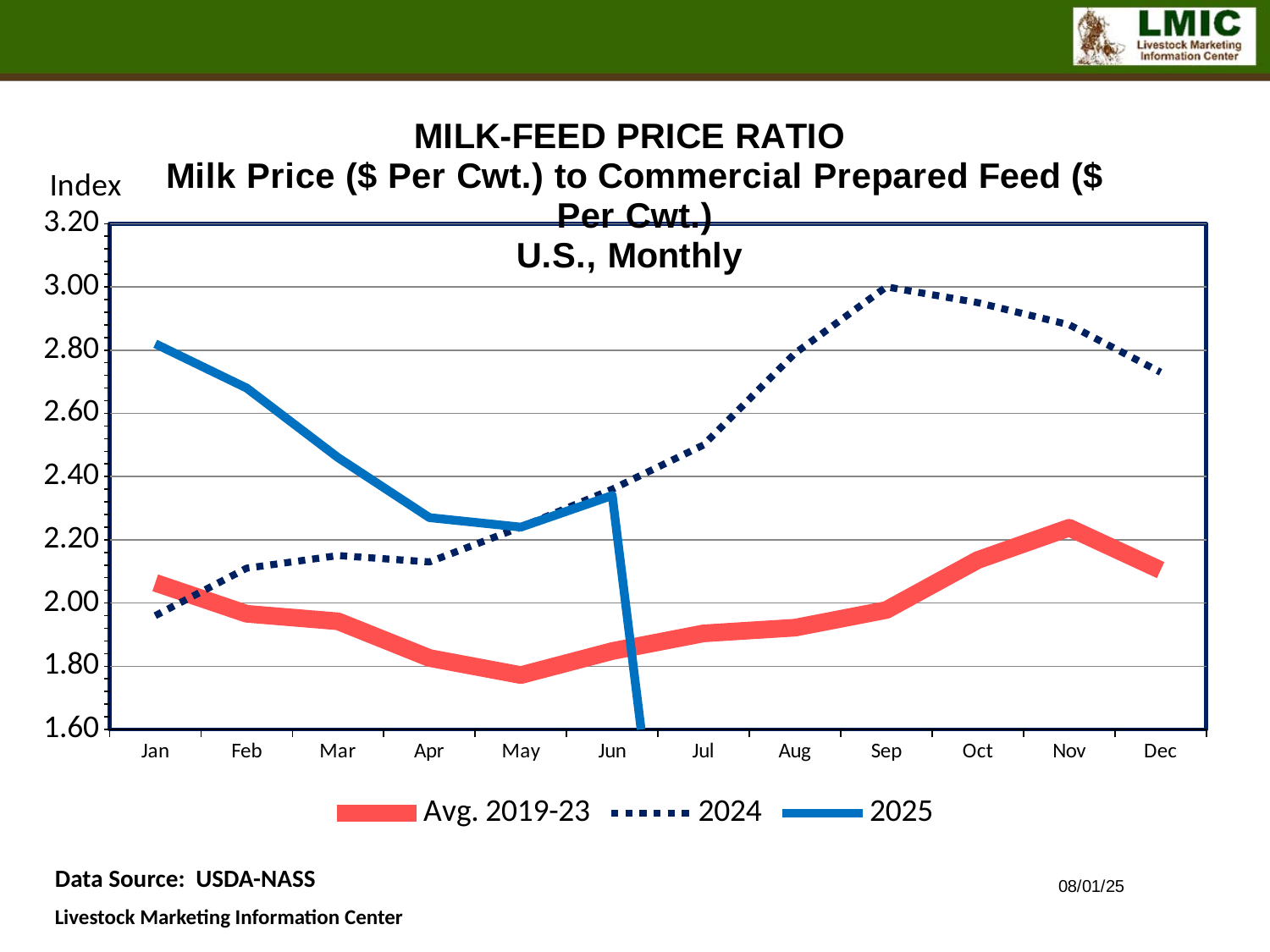
In which month does the Avg. 2019-23 series reach its lowest value? May Is the value for 2024 in Dec greater or less than 2.60? greater In which month does the Avg. 2019-23 series reach its highest value? Nov In which month does the 2024 series reach its highest value? Sep In which month is the 2025 series at its highest value? Jan Is the value for 2025 in Jan greater or less than 2.60? greater Does the 2025 series rise or fall from Jan to May? fall How many series does the legend list? 3 What kind of chart is shown on the slide? line chart How many months are shown along the x axis? 12 Is the value for Avg. 2019-23 in May greater or less than 2.00? less In Sep, which series has the larger value, 2024 or Avg. 2019-23? 2024